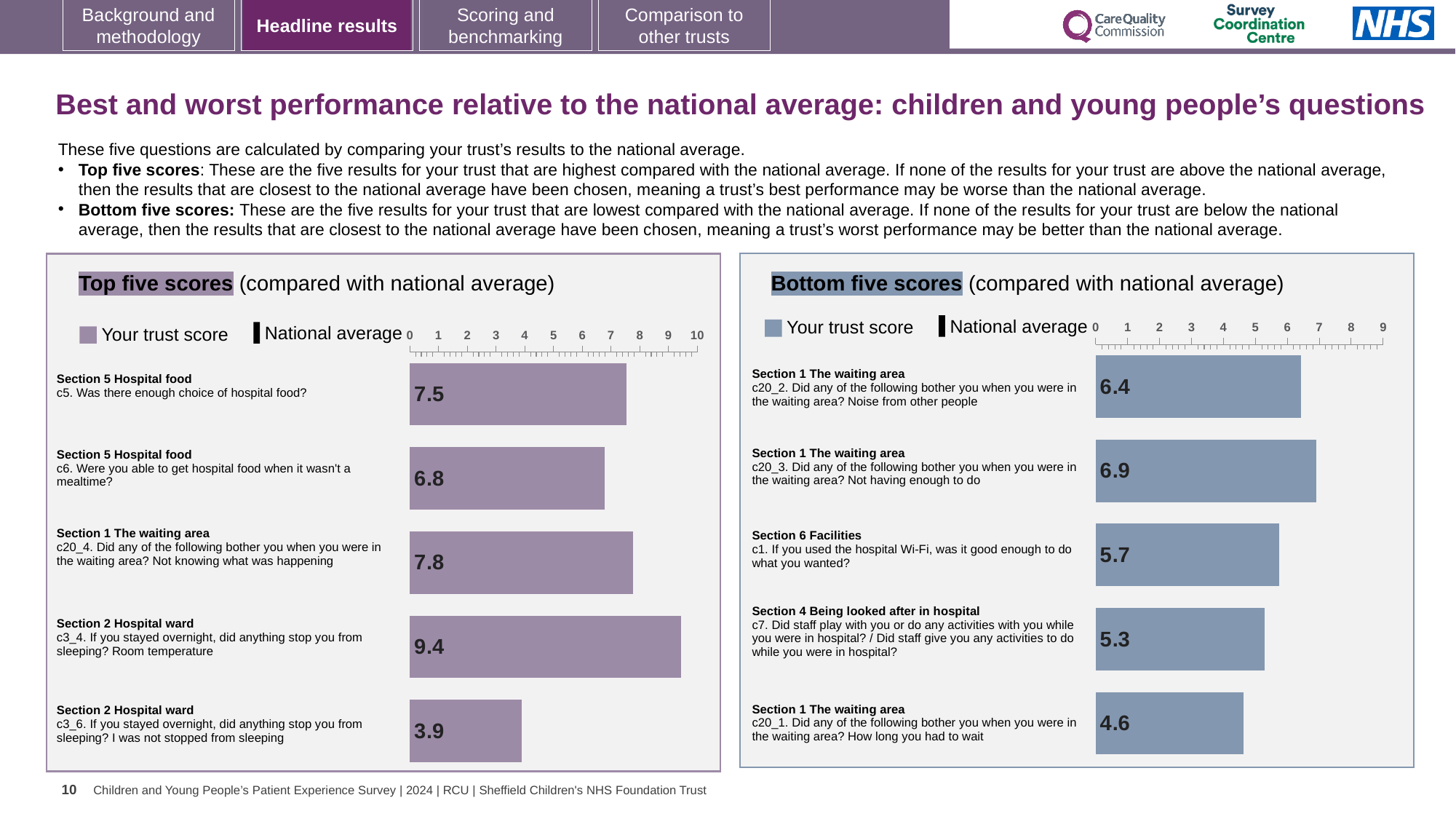
In the Top five scores chart, which question has the highest trust score? c3_4. Room temperature (9.4) In the Bottom five scores chart, which question has the lowest trust score? c20_1. How long you had to wait (4.6) In the Top five scores chart, what is the difference between the scores for c3_4 'Room temperature' and c3_6 'I was not stopped from sleeping'? 5.5 In the Top five scores chart, what is the trust score for c5 'Was there enough choice of hospital food?' 7.5 How many bars are shown in the Top five scores chart? 5 In the Bottom five scores chart, what is the trust score for c1 about the hospital Wi-Fi? 5.7 What type of chart is used for the Bottom five scores? Bar chart In the Bottom five scores chart, what is the difference between the highest score (6.9) and the lowest score (4.6)? 2.3 In the Bottom five scores chart, which has the larger trust score: c20_2 'Noise from other people' or c7 about staff playing or doing activities? c20_2. Noise from other people (6.4) In the Top five scores chart, which question has the lowest trust score? c3_6. I was not stopped from sleeping (3.9) In the Bottom five scores chart, which question has the highest trust score? c20_3. Not having enough to do (6.9) In the Top five scores chart, what is the trust score for c3_4 'Room temperature'? 9.4